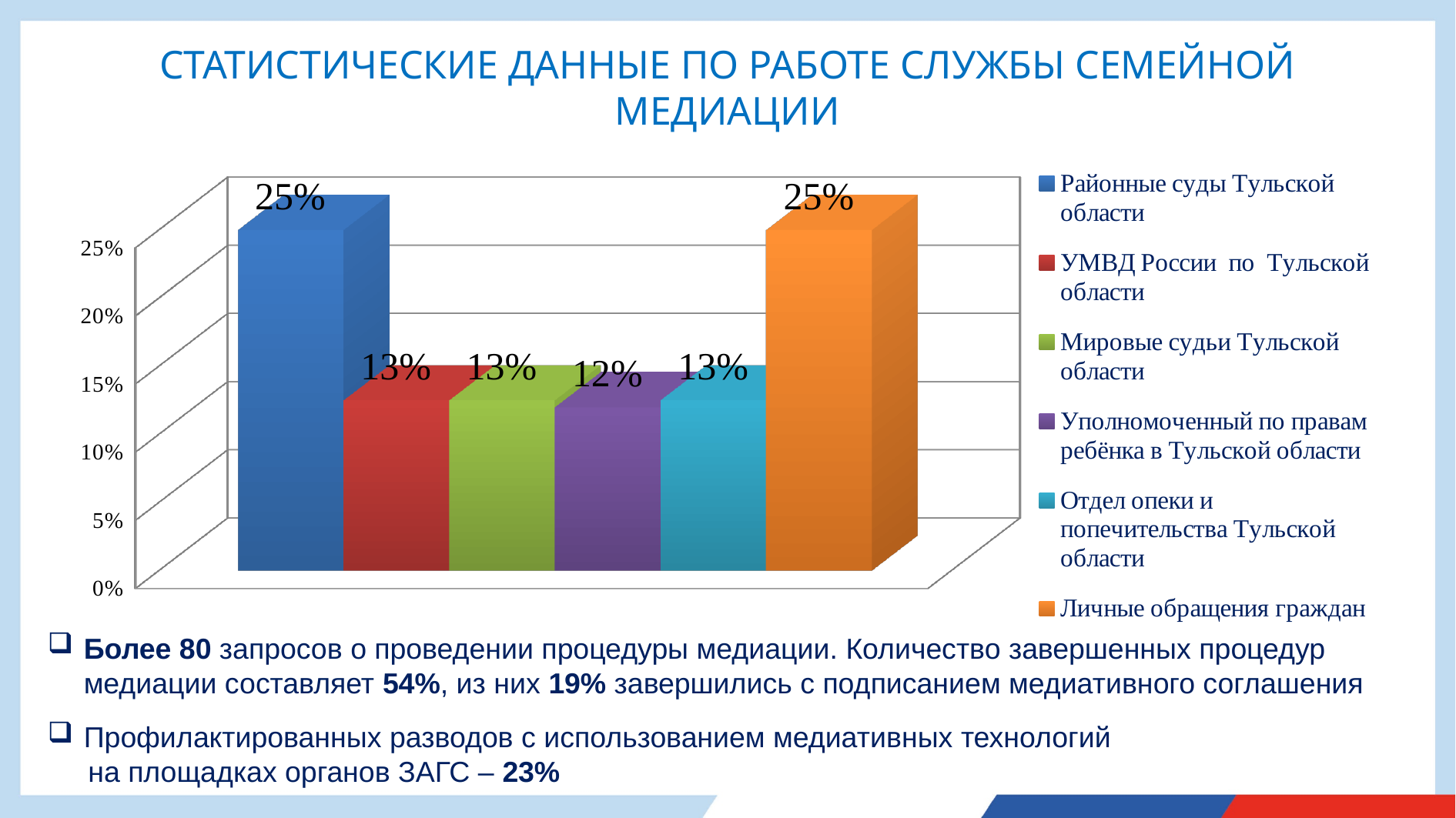
What value is shown for Районные суды Тульской области? 25% How many bars are plotted in the chart? 6 Is the value for Мировые судьи Тульской области greater or less than 20%? less Which is larger: the value for Личные обращения граждан or the value for Отдел опеки и попечительства Тульской области? Личные обращения граждан What is the difference between the values for Районные суды Тульской области and Мировые судьи Тульской области? 12% What value is shown for Личные обращения граждан? 25% What kind of chart is shown on the slide? bar chart What value is shown for Уполномоченный по правам ребёнка в Тульской области? 12% What value is shown for Отдел опеки и попечительства Тульской области? 13% What value is shown for УМВД России по Тульской области? 13% Which category has the lowest value? Уполномоченный по правам ребёнка в Тульской области How many entries does the legend list? 6